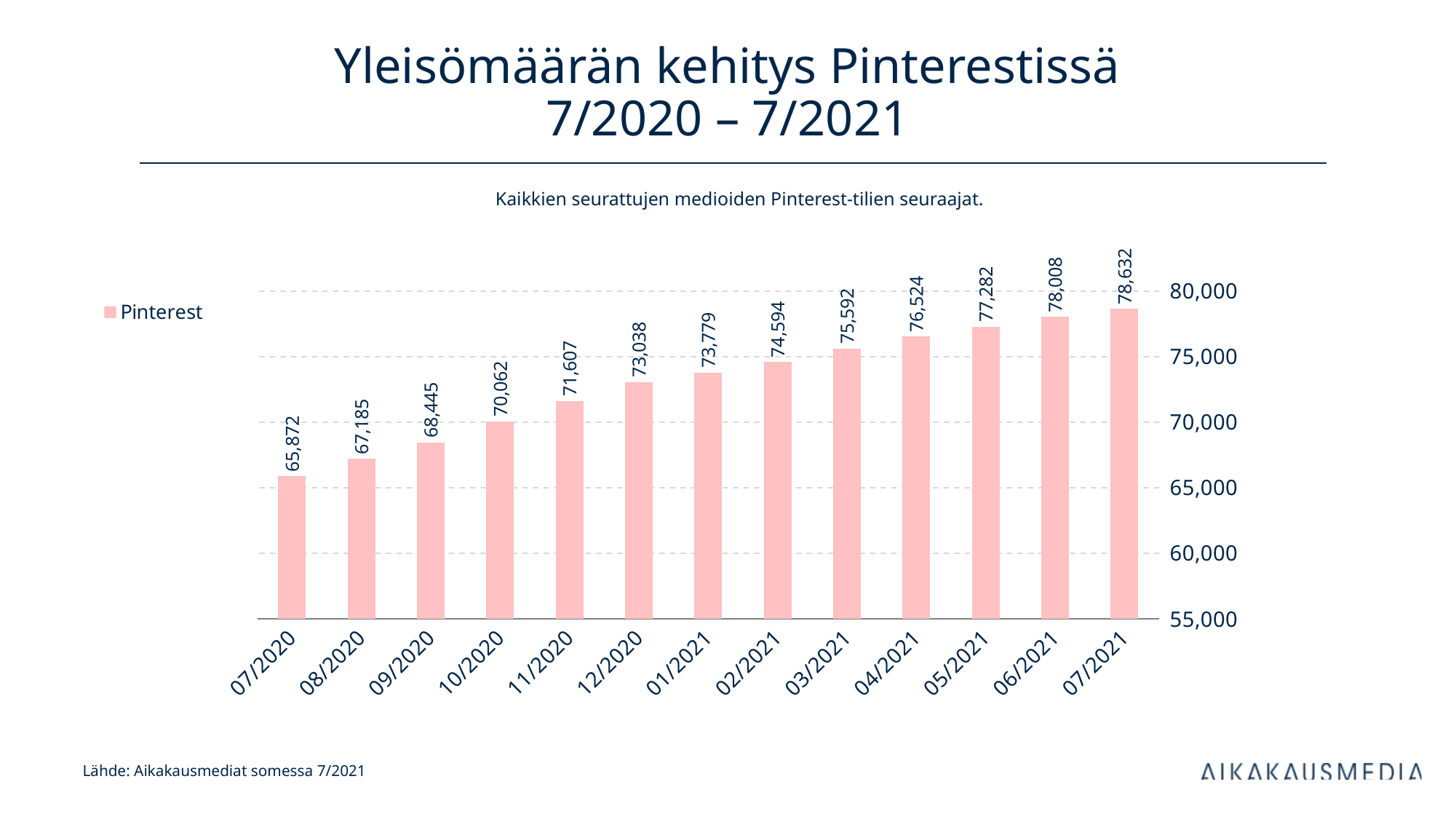
How many months are shown on the x axis? 13 What is the value for 07/2021? 78,632 Which month has the lowest value? 07/2020 What kind of chart is shown? bar chart What is the difference between the values for 12/2020 and 11/2020? 1,431 What is the difference between the values for 07/2021 and 07/2020? 12,760 Do the values rise or fall from 07/2020 to 07/2021? rise What is the value for 01/2021? 73,779 Which is larger, the value for 03/2021 or the value for 10/2020? 03/2021 Which month has the highest value? 07/2021 What is the value for 07/2020? 65,872 Is the value for 09/2020 greater or less than 70,000? less